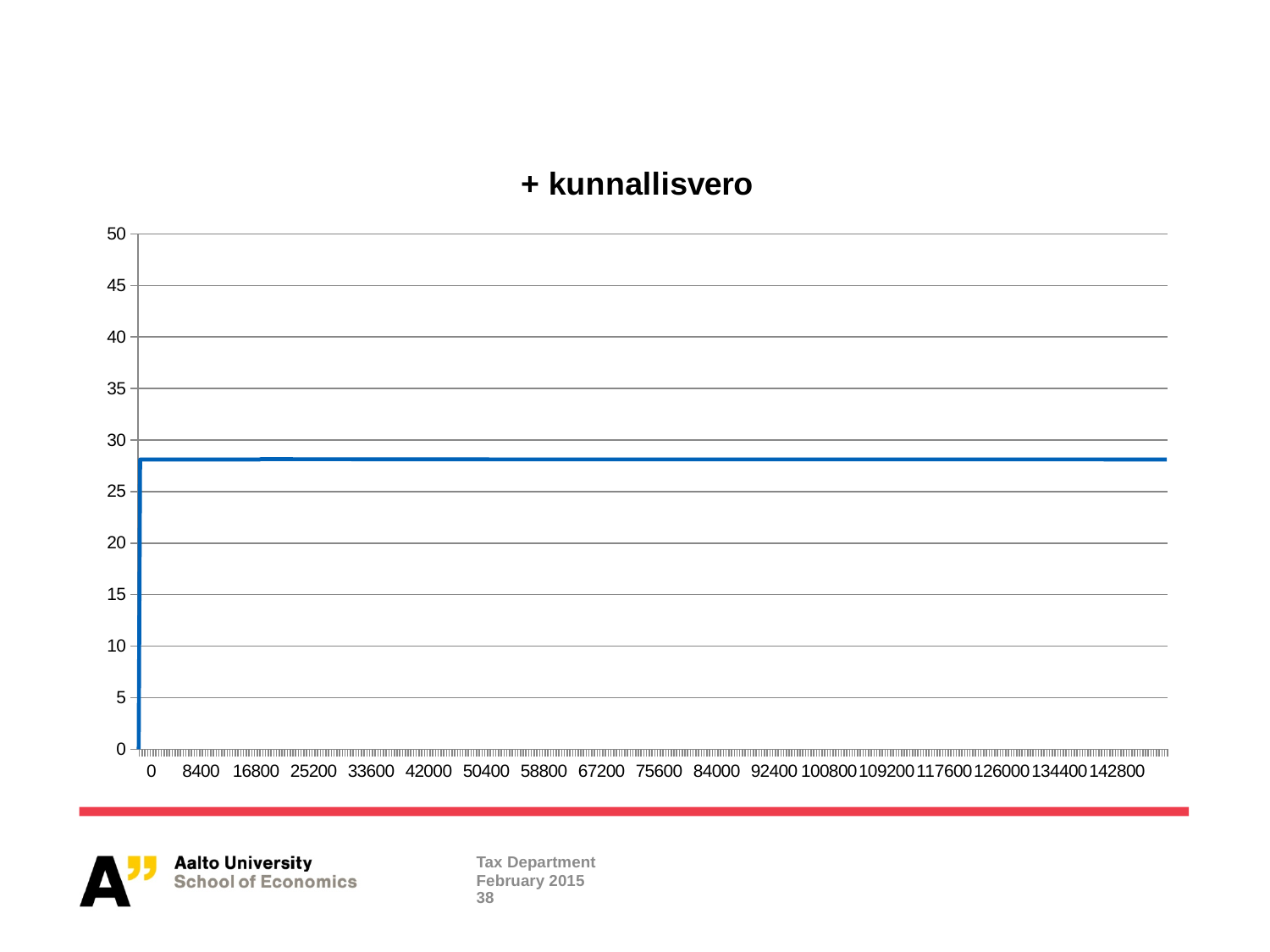
Between 8400 and 142800 on the x axis, does the line rise, fall, or stay flat? stay flat How many tick labels are shown on the x axis of the chart? 18 Is the value of the line at 100800 greater or less than 25? greater What kind of chart is shown on the slide? line chart What is the highest value shown on the y axis of the chart? 50 Is the value of the line at 8400 greater or less than 20? greater What is the last tick label on the x axis of the chart? 142800 Is the value of the line at 42000 greater or less than 30? less How many lines are plotted in the chart? 1 What colour is the plotted line in the chart? blue